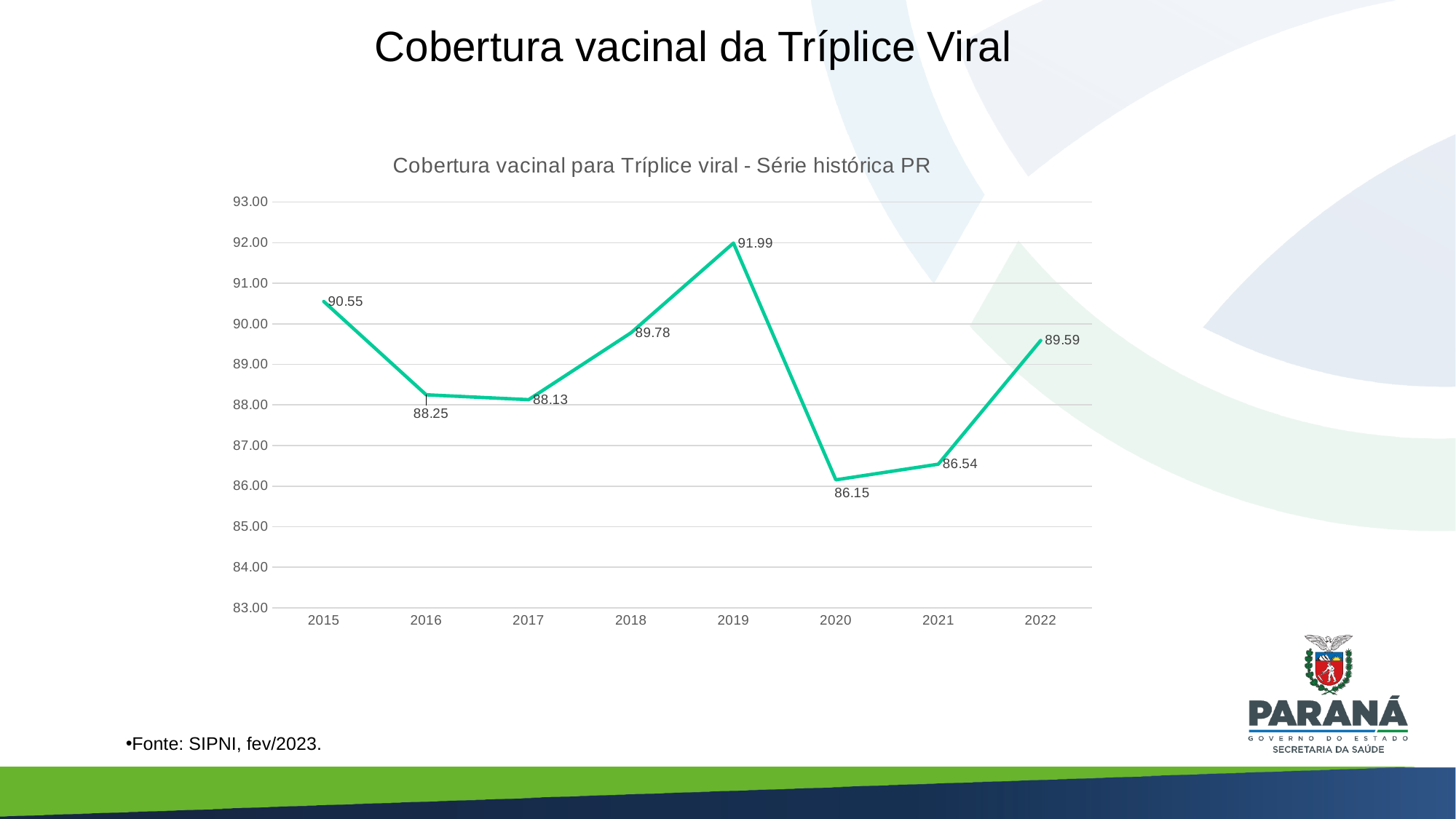
What kind of chart is shown? line chart Which year has the lowest value? 2020 What is the value for 2019? 91.99 Which is larger, the value for 2016 or the value for 2017? 2016 What is the value for 2015? 90.55 What is the title of the chart? Cobertura vacinal para Tríplice viral - Série histórica PR What is the difference between the values for 2019 and 2020? 5.84 What is the value for 2022? 89.59 Is the value for 2018 greater or less than 89.00? greater What is the value for 2020? 86.15 How many years are plotted on the chart? 8 Which year has the highest value? 2019